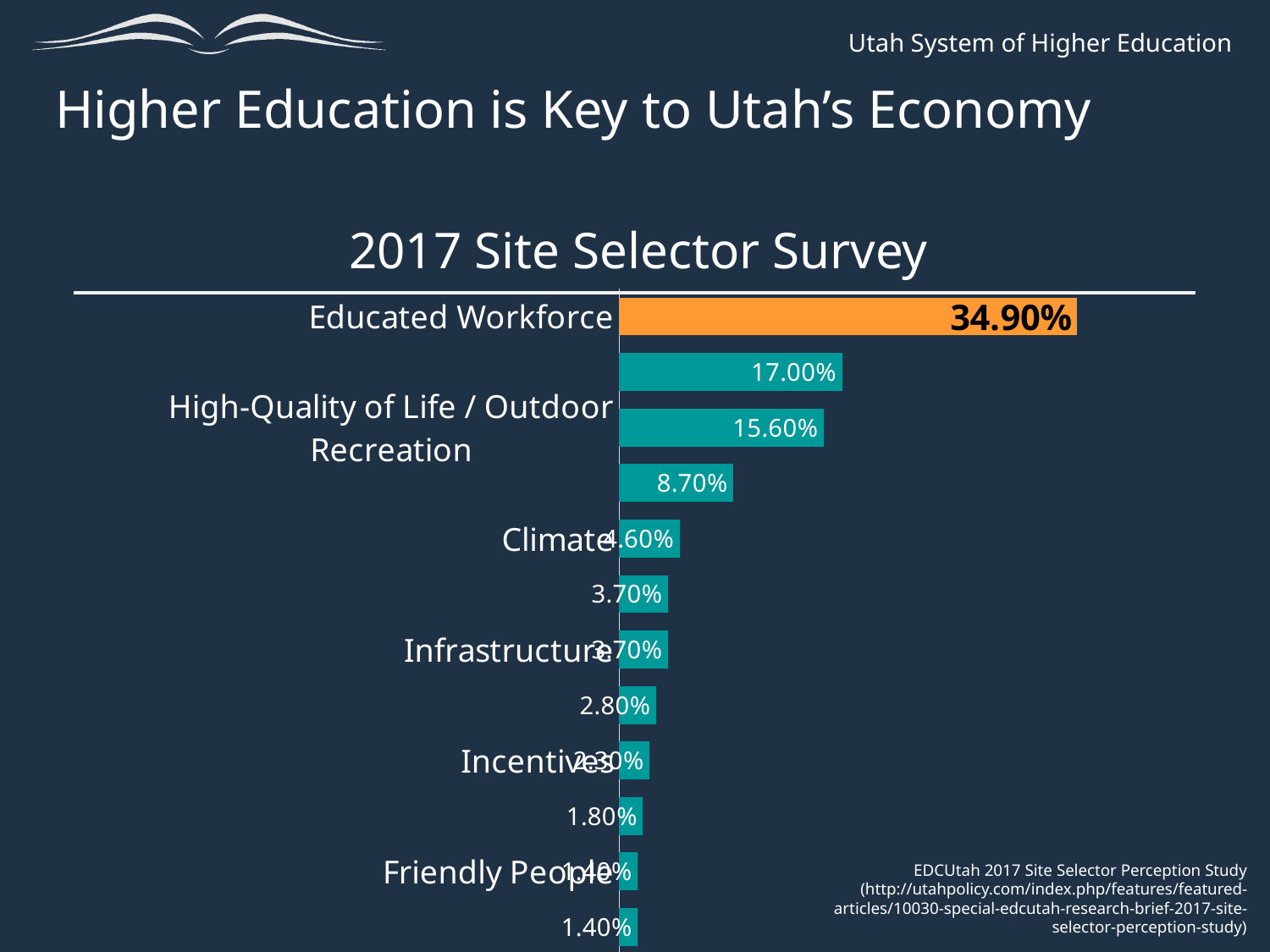
What is the value for High-Quality of Life / Outdoor Recreation? 15.60% Which category has the highest value in the chart? Educated Workforce What is the value for Infrastructure? 3.70% What is the difference between the values for Educated Workforce and High-Quality of Life / Outdoor Recreation? 19.30% What is the title of the chart? 2017 Site Selector Survey What is the value for Climate? 4.60% How many bars are plotted in the chart? 12 What kind of chart is shown on the slide? Bar chart What is the value for Educated Workforce in the 2017 Site Selector Survey chart? 34.90% Which has a larger value, Climate or Infrastructure? Climate What is the value for Friendly People? 1.40% What is the value for Incentives? 2.30%